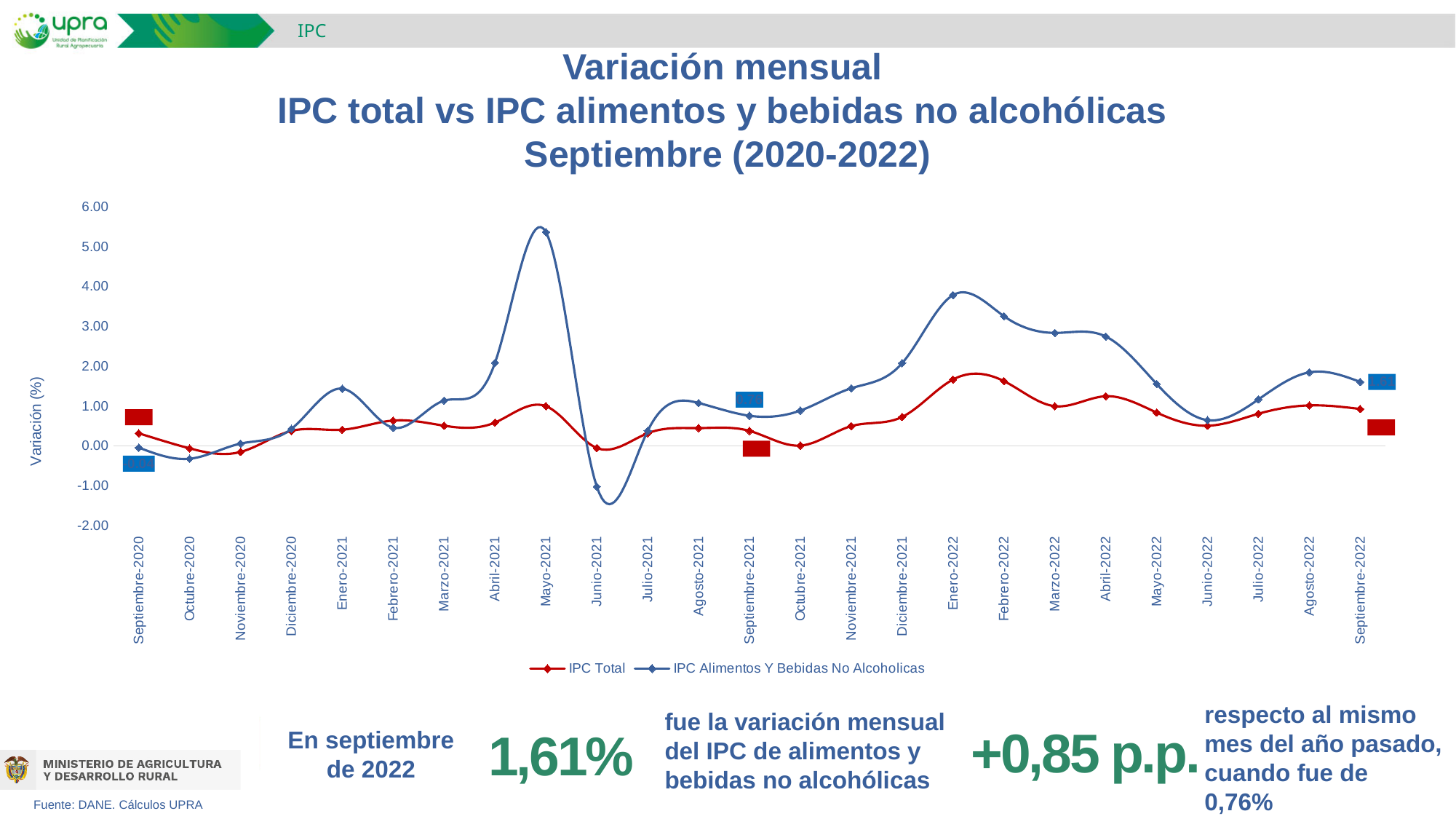
What kind of chart is shown on the slide? line chart What is the title of the y axis? Variación (%) In which month does the IPC Alimentos Y Bebidas No Alcoholicas series reach its highest value? Mayo-2021 How many series does the legend list? 2 How many months (data points) are plotted along the x axis? 25 In which month does the IPC Total series reach its highest value? Enero-2022 Is the value of IPC Alimentos Y Bebidas No Alcoholicas in Mayo-2021 greater or less than 5.00? greater Does the IPC Alimentos Y Bebidas No Alcoholicas series rise or fall from Enero-2022 to Junio-2022? fall Is the value of IPC Alimentos Y Bebidas No Alcoholicas in Enero-2022 greater or less than 3.00? greater In Mayo-2021, which series has the larger value, IPC Total or IPC Alimentos Y Bebidas No Alcoholicas? IPC Alimentos Y Bebidas No Alcoholicas Is the value of IPC Alimentos Y Bebidas No Alcoholicas in Junio-2021 greater or less than 0.00? less In which month does the IPC Alimentos Y Bebidas No Alcoholicas series reach its lowest value? Junio-2021